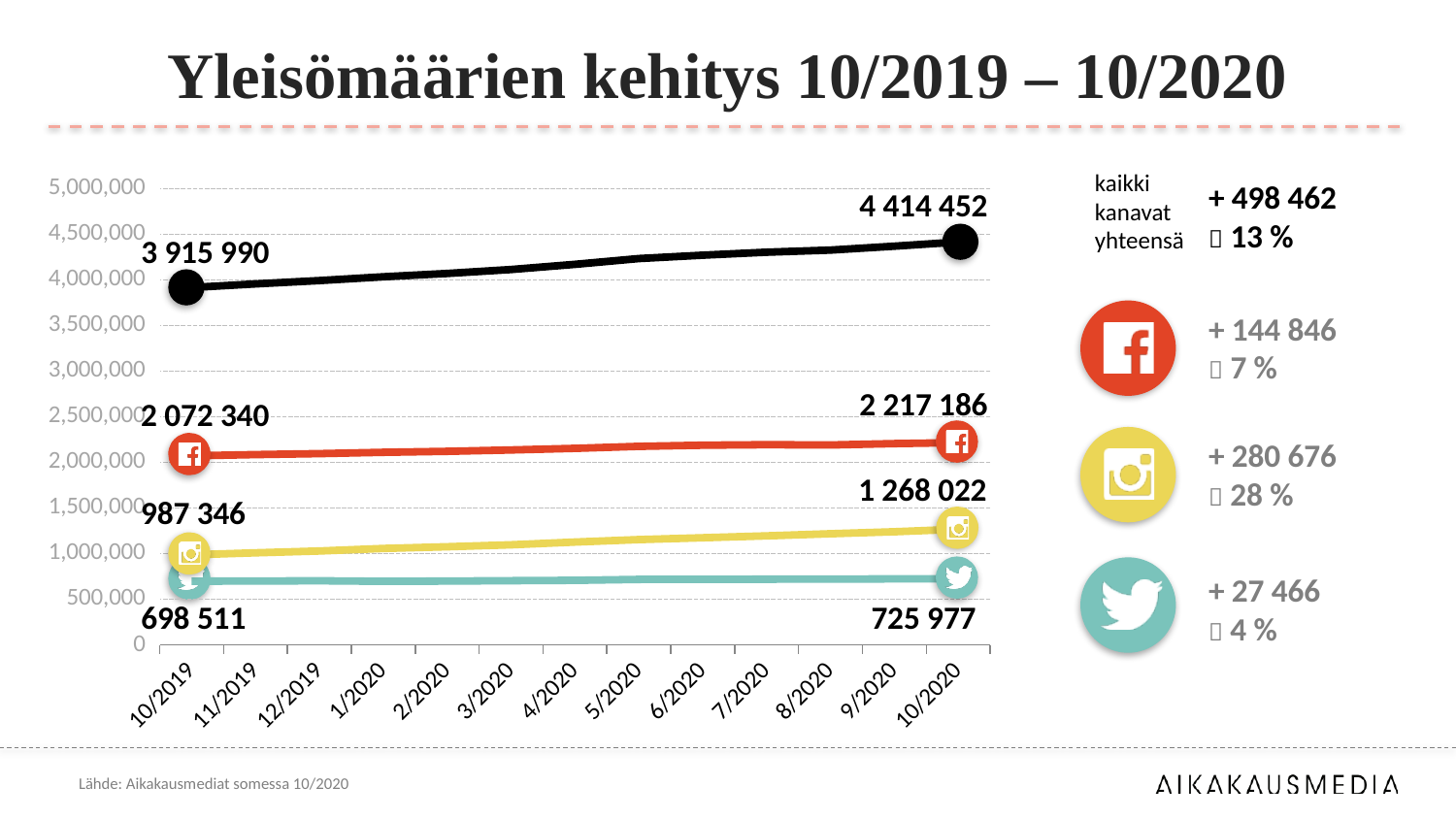
How many months are shown on the x axis? 13 By how much did the yellow Instagram line increase from 10/2019 to 10/2020? 280 676 What is the value of the yellow Instagram line at 10/2019? 987 346 What is the value of the black (total) line at 10/2020? 4 414 452 What is the value of the black (total) line at 10/2019? 3 915 990 At 10/2020, which is larger: the Instagram value or the Twitter value? Instagram Which line has the lowest value at 10/2020? the teal Twitter line By how much did the black (total) line increase from 10/2019 to 10/2020? 498 462 What is the value of the teal Twitter line at 10/2020? 725 977 Is the value of the teal Twitter line at 4/2020 greater or less than 1,000,000? less What is the value of the red Facebook line at 10/2020? 2 217 186 What kind of chart is shown on the slide? line chart